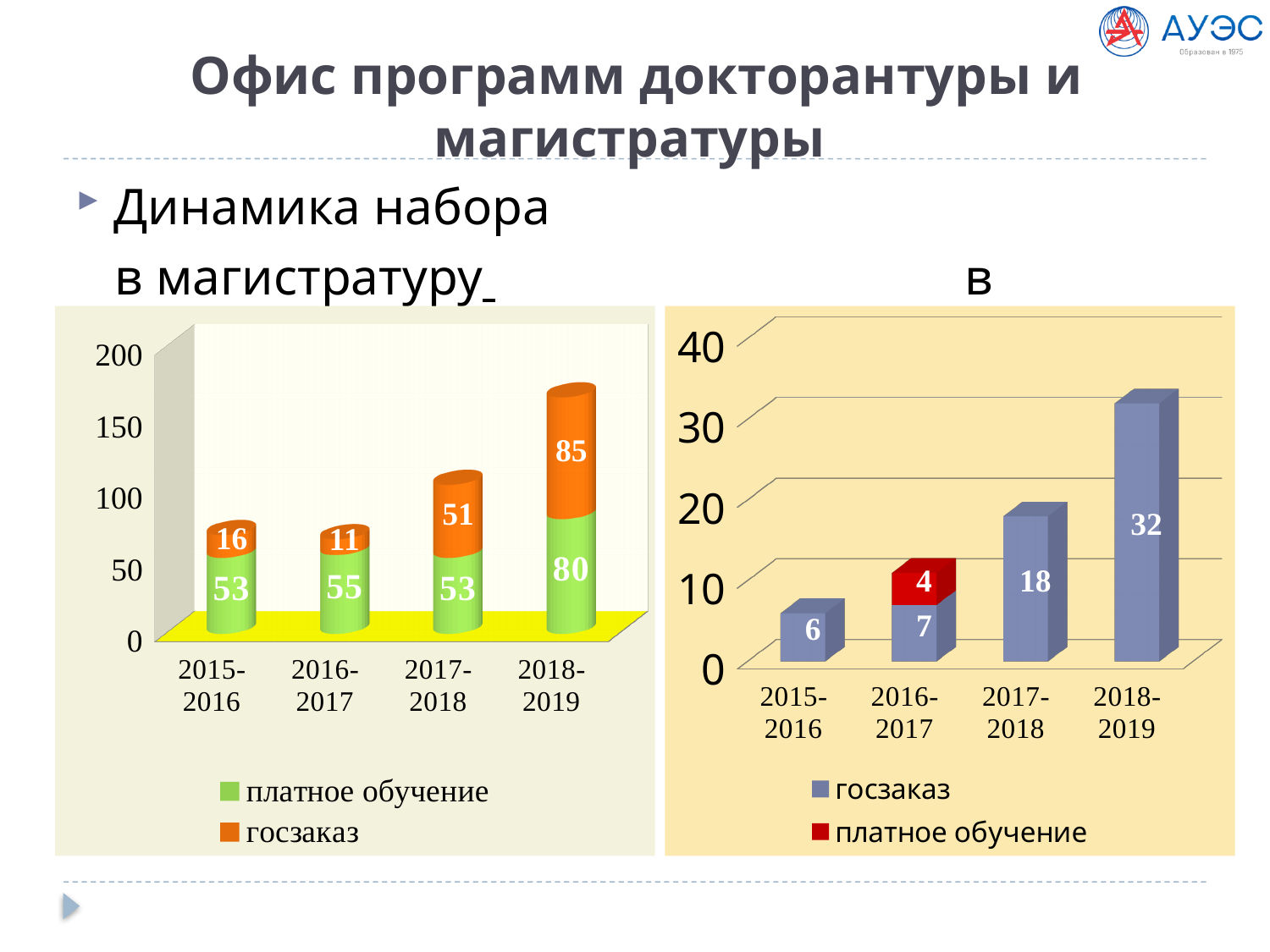
In the left chart, what is the value for платное обучение in 2018-2019? 80 In the right chart, what is the value for госзаказ in 2018-2019? 32 In the right chart, which year has the lowest госзаказ value? 2015-2016 In the right chart, what is the value for платное обучение in 2016-2017? 4 In the left chart, what is the total of the stacked bar for 2018-2019? 165 In the right chart, what is the difference between госзаказ in 2018-2019 and госзаказ in 2017-2018? 14 In the left chart, what is the difference between госзаказ in 2018-2019 and госзаказ in 2017-2018? 34 What type of chart is the left chart? Bar chart In the left chart, what is the total of the stacked bar for 2015-2016? 69 In the left chart, what is the value for госзаказ in 2016-2017? 11 How many series does the legend of the right chart list? 2 In the left chart, which year has the highest госзаказ value? 2018-2019